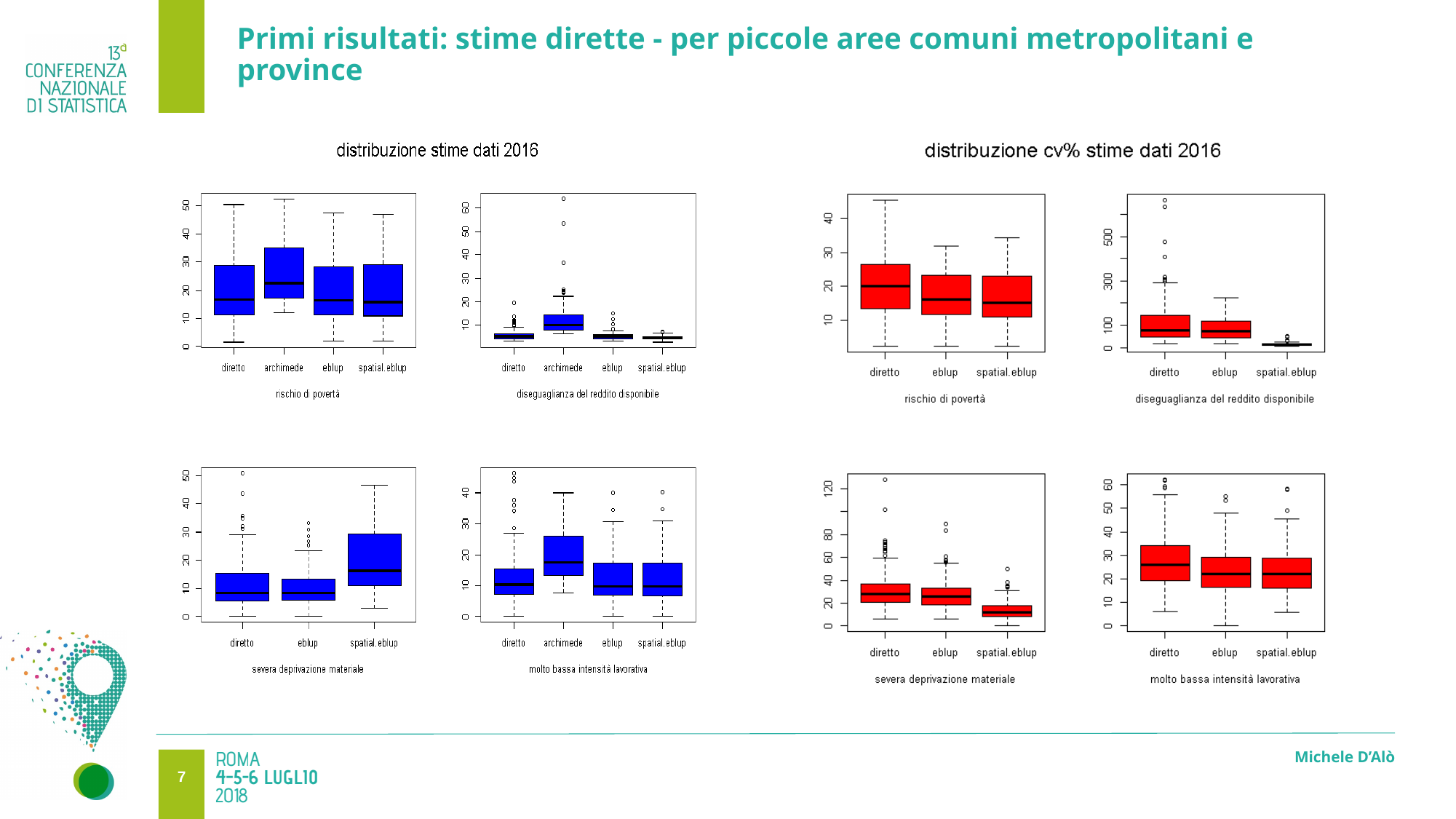
In the 'molto bassa intensità lavorativa' panel under 'distribuzione stime dati 2016', which category has the highest median? archimede In the 'molto bassa intensità lavorativa' panel under 'distribuzione cv% stime dati 2016', is the median for diretto greater or less than 20? greater In the 'rischio di povertà' panel under 'distribuzione stime dati 2016', how many categories are shown on the x axis? 4 What colour are the boxes in the 'distribuzione cv% stime dati 2016' panels? red What is the title of the group of charts on the right side of the slide? distribuzione cv% stime dati 2016 In the 'diseguaglianza del reddito disponibile' panel under 'distribuzione cv% stime dati 2016', is the median for spatial.eblup greater or less than 100? less In the 'rischio di povertà' panel under 'distribuzione stime dati 2016', is the median for archimede greater or less than 20? greater In the 'severa deprivazione materiale' panel under 'distribuzione stime dati 2016', which has the higher median, diretto or spatial.eblup? spatial.eblup In the 'severa deprivazione materiale' panel under 'distribuzione stime dati 2016', how many categories are shown on the x axis? 3 In the 'severa deprivazione materiale' panel under 'distribuzione cv% stime dati 2016', which category has the lowest median? spatial.eblup In the 'rischio di povertà' panel under 'distribuzione cv% stime dati 2016', how many categories are shown on the x axis? 3 What kind of chart is used in the 'rischio di povertà' panel under 'distribuzione stime dati 2016'? box plot